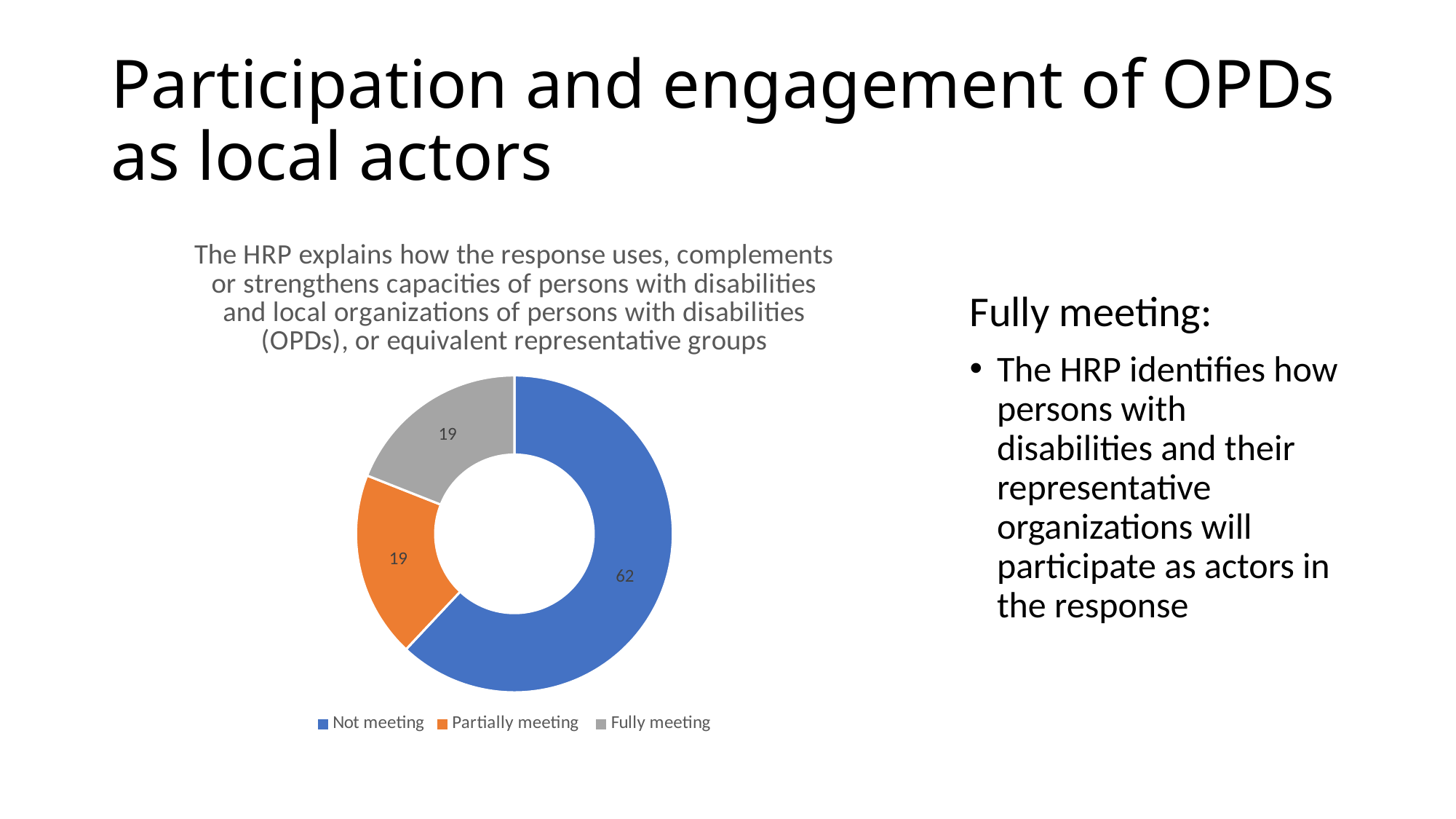
What is the value for Not meeting? 62 What is the value for Fully meeting? 19 Which category has the highest value? Not meeting What is the difference between the values for Not meeting and Fully meeting? 43 What colour is the Partially meeting slice? Orange What kind of chart is shown on the slide? Doughnut chart What share of the chart does the Not meeting slice represent? 62% How many categories does the chart show? 3 What is the value for Partially meeting? 19 How many entries does the legend list? 3 Which is larger, the value for Not meeting or the value for Partially meeting? Not meeting What is the total of all the values shown in the chart? 100